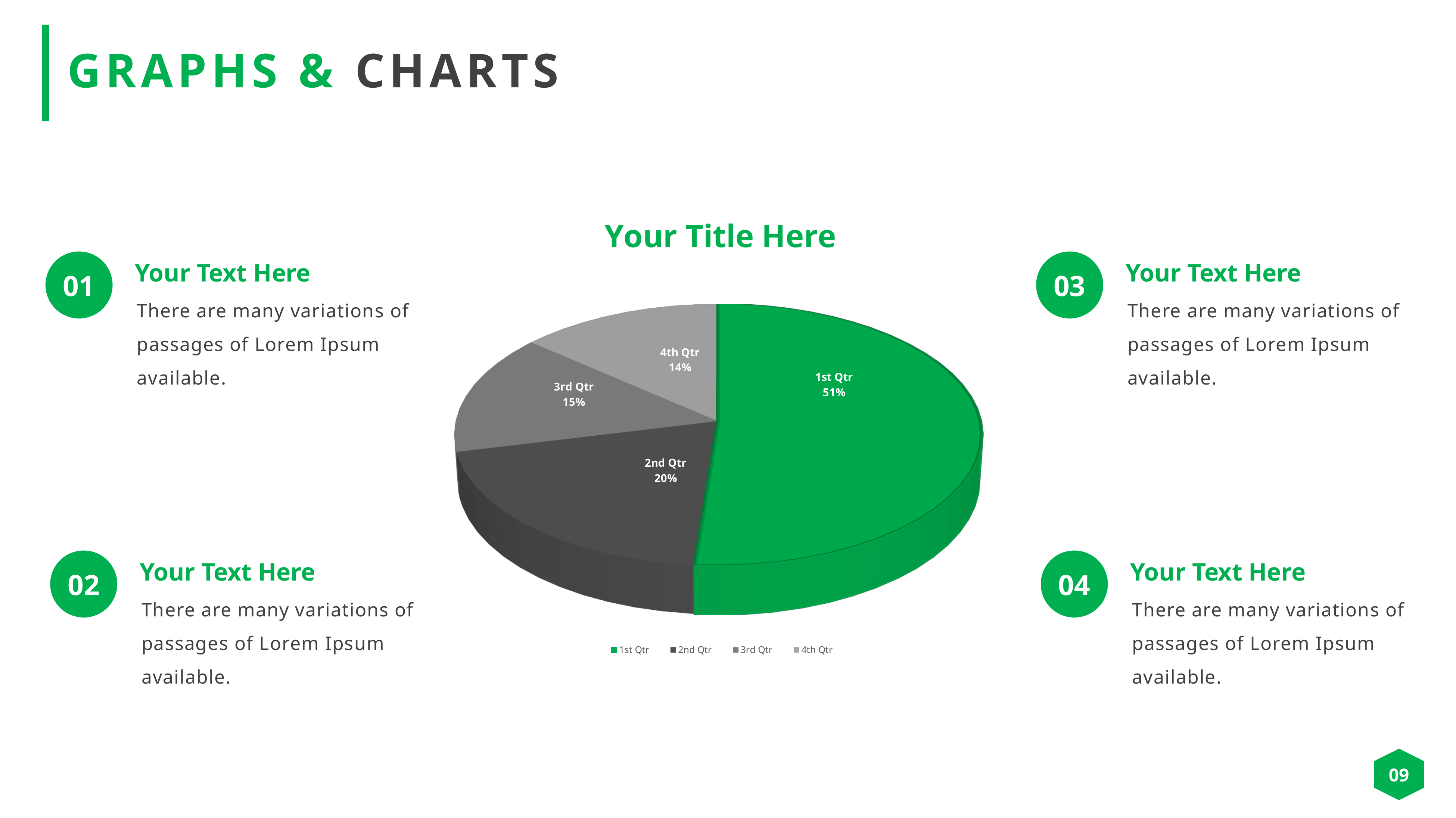
What percentage does the 1st Qtr slice represent in the pie chart? 51% What is the title of the chart? Your Title Here What type of chart is shown on the slide? Pie chart What percentage does the 3rd Qtr slice represent in the pie chart? 15% Which quarter has the smallest slice in the pie chart? 4th Qtr What colour is the 1st Qtr slice in the pie chart? Green Which quarter has the largest slice in the pie chart? 1st Qtr How many slices does the pie chart have? 4 What percentage does the 2nd Qtr slice represent in the pie chart? 20% What percentage does the 4th Qtr slice represent in the pie chart? 14% Which slice is larger, 2nd Qtr or 3rd Qtr? 2nd Qtr What is the difference in percentage points between the 1st Qtr and 2nd Qtr slices? 31